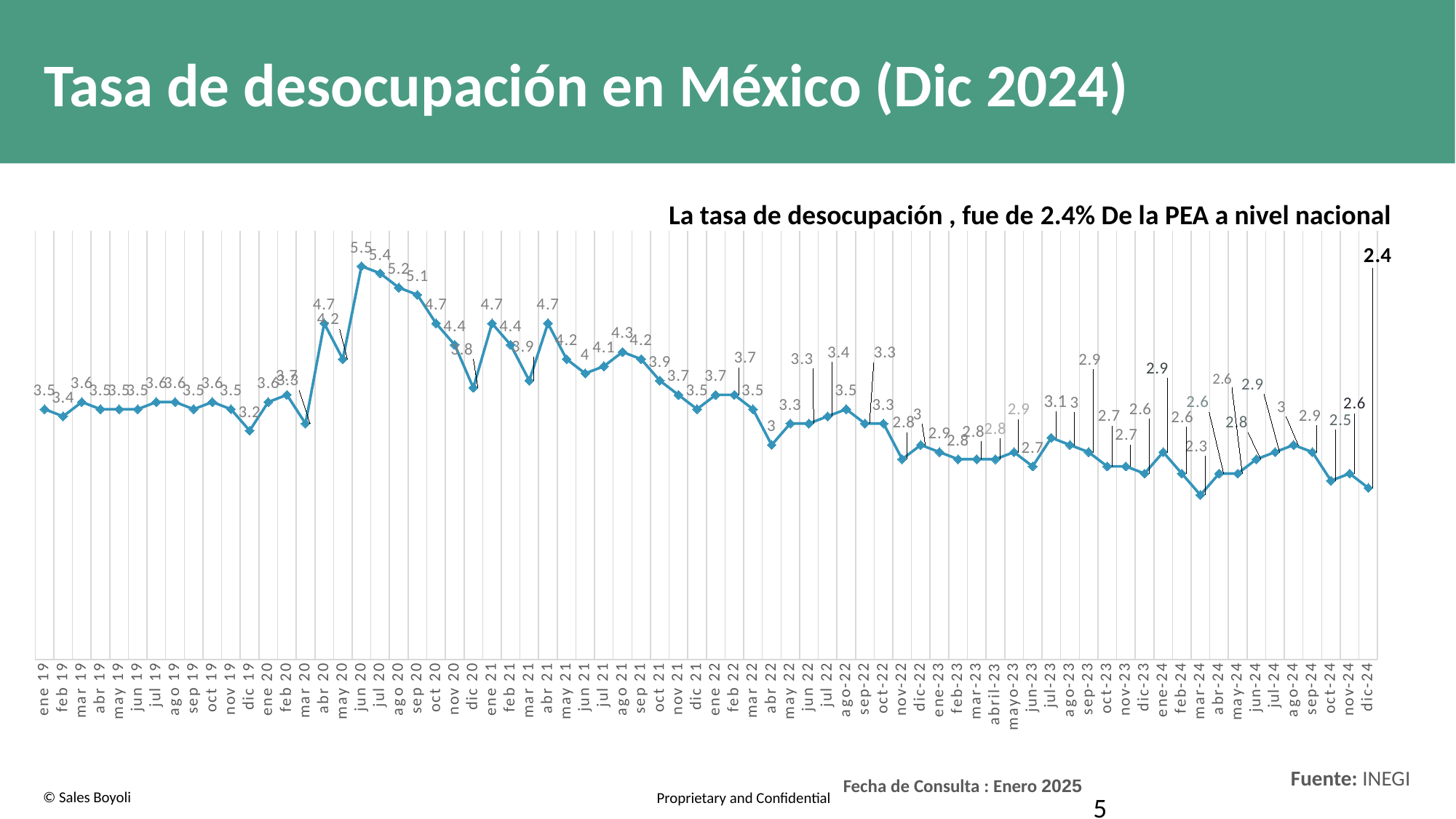
Which month has the highest unemployment rate in the chart? jun 20 What is the title of the slide containing the chart? Tasa de desocupación en México (Dic 2024) What is the unemployment rate value for dic-24? 2.4 What is the difference between the value for jun 20 and the value for dic-24? 3.1 Which is larger, the value for abr 20 or the value for may 20? abr 20 What is the value plotted for mar-24? 2.3 Does the unemployment rate rise or fall from jun 20 to dic 20? fall What is the value plotted for dic 19? 3.2 Which month has the lowest unemployment rate in the chart? mar-24 What is the difference between the value for jul-23 and the value for jun-23? 0.4 What is the value plotted for jun 20? 5.5 What type of chart is shown on the slide? line chart